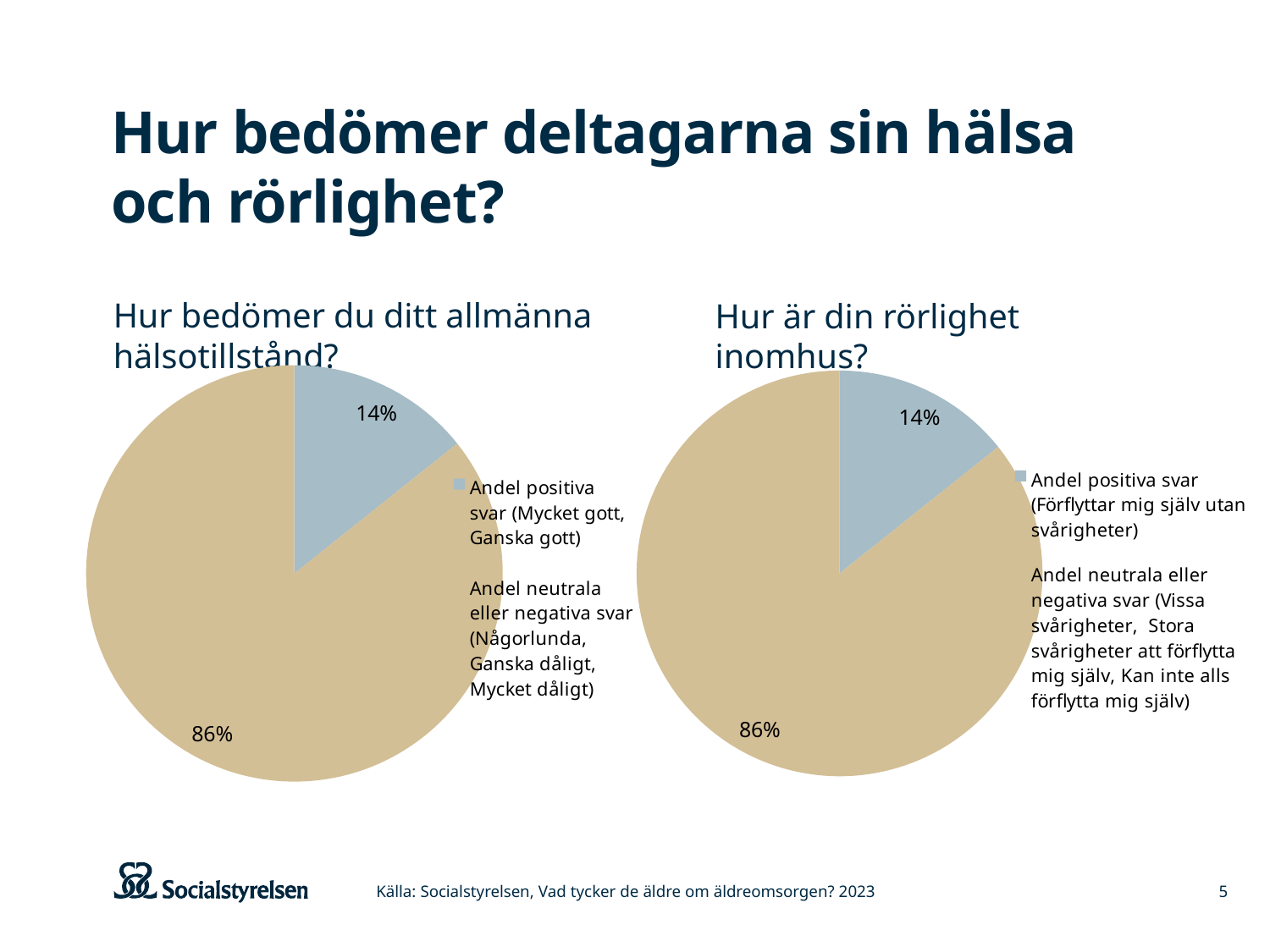
In the left chart 'Hur bedömer du ditt allmänna hälsotillstånd?', what share of responses is 'Andel neutrala eller negativa svar'? 86% In the right chart 'Hur är din rörlighet inomhus?', what colour is the 'Andel positiva svar' slice? Light blue-grey In the left chart 'Hur bedömer du ditt allmänna hälsotillstånd?', which category has the largest slice? Andel neutrala eller negativa svar In the right chart 'Hur är din rörlighet inomhus?', which category has the smallest slice? Andel positiva svar What kind of chart is the left chart 'Hur bedömer du ditt allmänna hälsotillstånd?'? Pie chart How many entries does the legend of the left chart 'Hur bedömer du ditt allmänna hälsotillstånd?' list? 2 In the right chart 'Hur är din rörlighet inomhus?', what share of responses is 'Andel positiva svar'? 14% In the left chart 'Hur bedömer du ditt allmänna hälsotillstånd?', what is the difference in percentage points between the neutral/negative slice and the positive slice? 72 percentage points In the right chart 'Hur är din rörlighet inomhus?', what share of responses is 'Andel neutrala eller negativa svar'? 86% In the right chart 'Hur är din rörlighet inomhus?', which is larger: the positive slice or the neutral/negative slice? Andel neutrala eller negativa svar In the left chart 'Hur bedömer du ditt allmänna hälsotillstånd?', what share of responses is 'Andel positiva svar'? 14% How many slices does the right chart 'Hur är din rörlighet inomhus?' have? 2